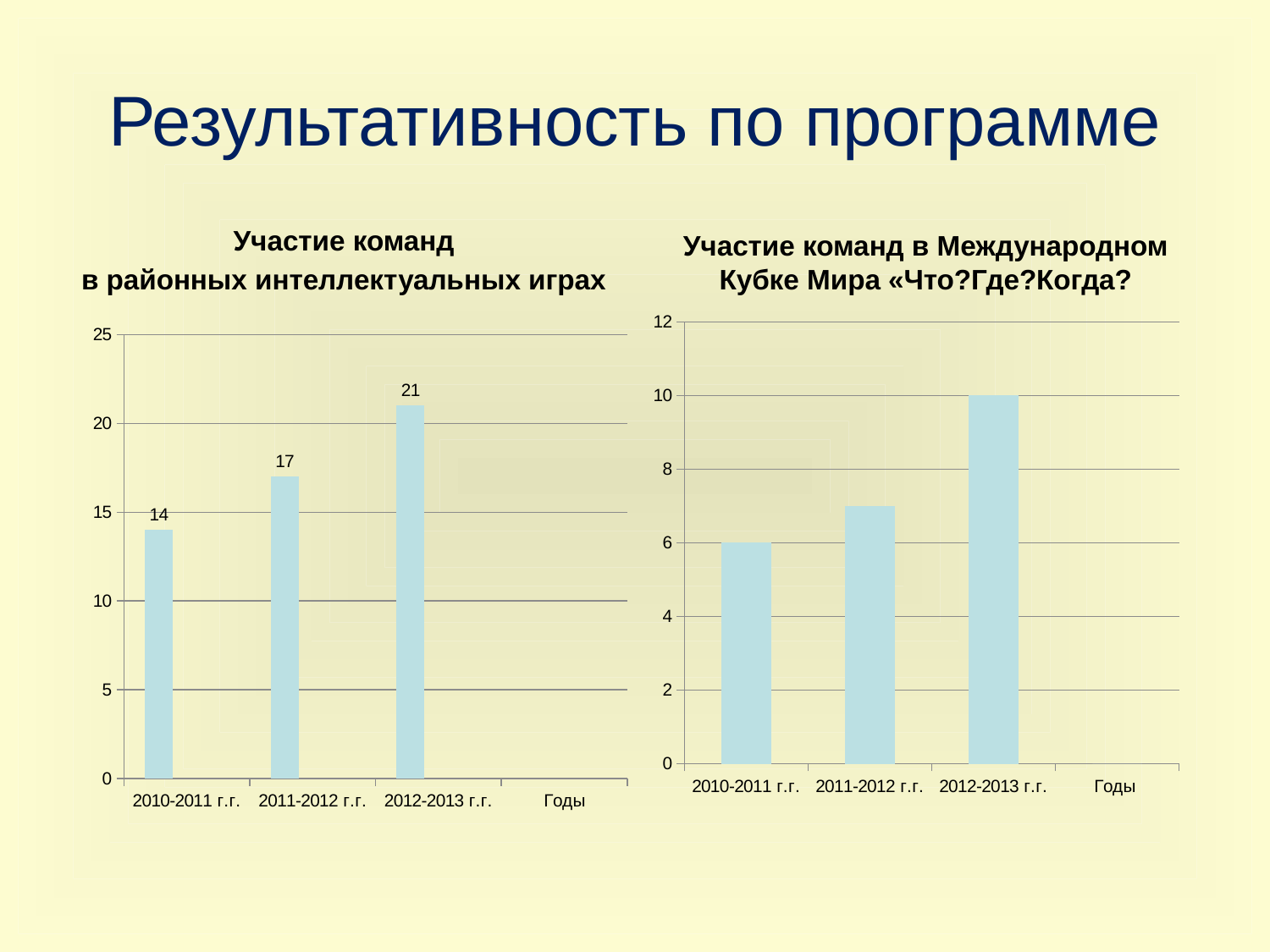
In the left chart (Участие команд в районных интеллектуальных играх), what is the value for 2012-2013 г.г.? 21 In the right chart (Участие команд в Международном Кубке Мира «Что?Где?Когда?»), how many bars are plotted? 3 In the right chart (Участие команд в Международном Кубке Мира «Что?Где?Когда?»), which year has the highest value? 2012-2013 г.г. In the left chart (Участие команд в районных интеллектуальных играх), what is the value for 2010-2011 г.г.? 14 In the left chart (Участие команд в районных интеллектуальных играх), which year has the lowest value? 2010-2011 г.г. In the left chart (Участие команд в районных интеллектуальных играх), which year has the highest value? 2012-2013 г.г. In the left chart (Участие команд в районных интеллектуальных играх), do the values rise or fall from 2010-2011 г.г. to 2012-2013 г.г.? rise In the left chart (Участие команд в районных интеллектуальных играх), what is the difference between the values for 2012-2013 г.г. and 2010-2011 г.г.? 7 What kind of chart is the left chart (Участие команд в районных интеллектуальных играх)? bar chart In the right chart (Участие команд в Международном Кубке Мира «Что?Где?Когда?»), what is the value for 2010-2011 г.г.? 6 In the right chart (Участие команд в Международном Кубке Мира «Что?Где?Когда?»), is the value for 2011-2012 г.г. greater or less than 8? less In the right chart (Участие команд в Международном Кубке Мира «Что?Где?Когда?»), what is the value for 2012-2013 г.г.? 10